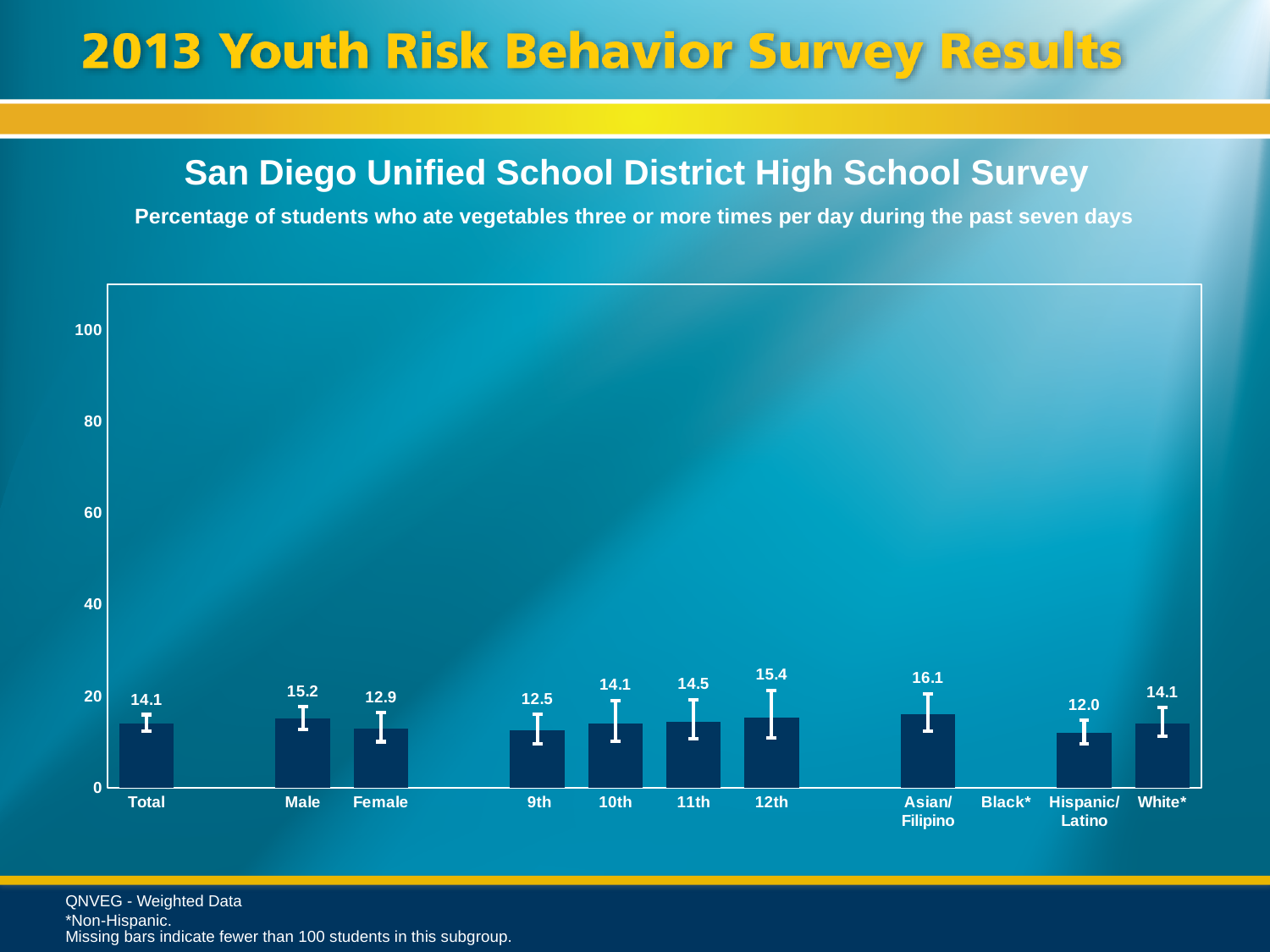
What is the value for Hispanic/Latino? 12.0 Which category has the highest value? Asian/Filipino What kind of chart is shown? bar chart What is the difference between the Male and Female values? 2.3 Do the values rise or fall from 9th to 12th grade? rise What is the value for Asian/Filipino? 16.1 Which category has the lowest plotted value? Hispanic/Latino Which category has no bar plotted? Black* Which is larger, the value for 12th or the value for 9th? 12th What is the value for Total? 14.1 What is the value for Male? 15.2 Is the value for White* greater or less than 20? less